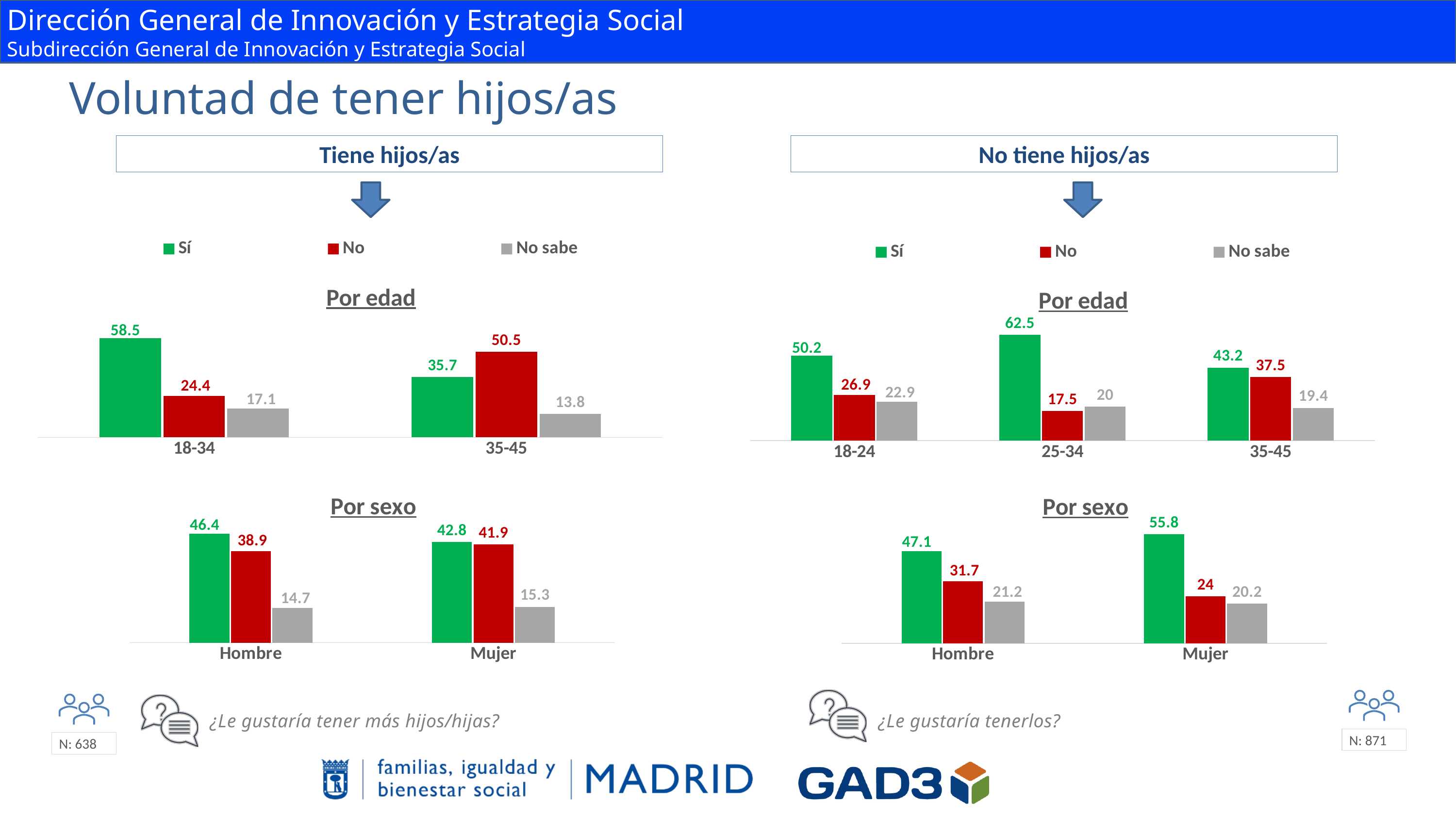
In the 'No tiene hijos/as' Por sexo chart, what is the difference between the 'Sí' values for Mujer and Hombre? 8.7 How many age groups are shown in the 'No tiene hijos/as' Por edad chart? 3 What type of chart is the 'Tiene hijos/as' Por sexo chart? Bar chart In the 'No tiene hijos/as' Por edad chart, which age group has the highest 'Sí' value? 25-34 In the 'Tiene hijos/as' Por edad chart, what is the value of 'No' for 35-45? 50.5 In the 'No tiene hijos/as' Por sexo chart, what is the value of 'No' for Mujer? 24 In the 'No tiene hijos/as' Por edad chart, what is the difference between the 'Sí' and 'No' values for 35-45? 5.7 In the 'Tiene hijos/as' Por sexo chart, which category has the lowest 'No sabe' value? Hombre In the 'Tiene hijos/as' Por sexo chart, which is larger for Mujer: 'Sí' or 'No'? Sí In the 'No tiene hijos/as' Por edad chart, what is the value of 'No sabe' for 25-34? 20 How many series does the legend of the 'Tiene hijos/as' charts list? 3 In the 'Tiene hijos/as' Por edad chart, what is the value of 'Sí' for 18-34? 58.5